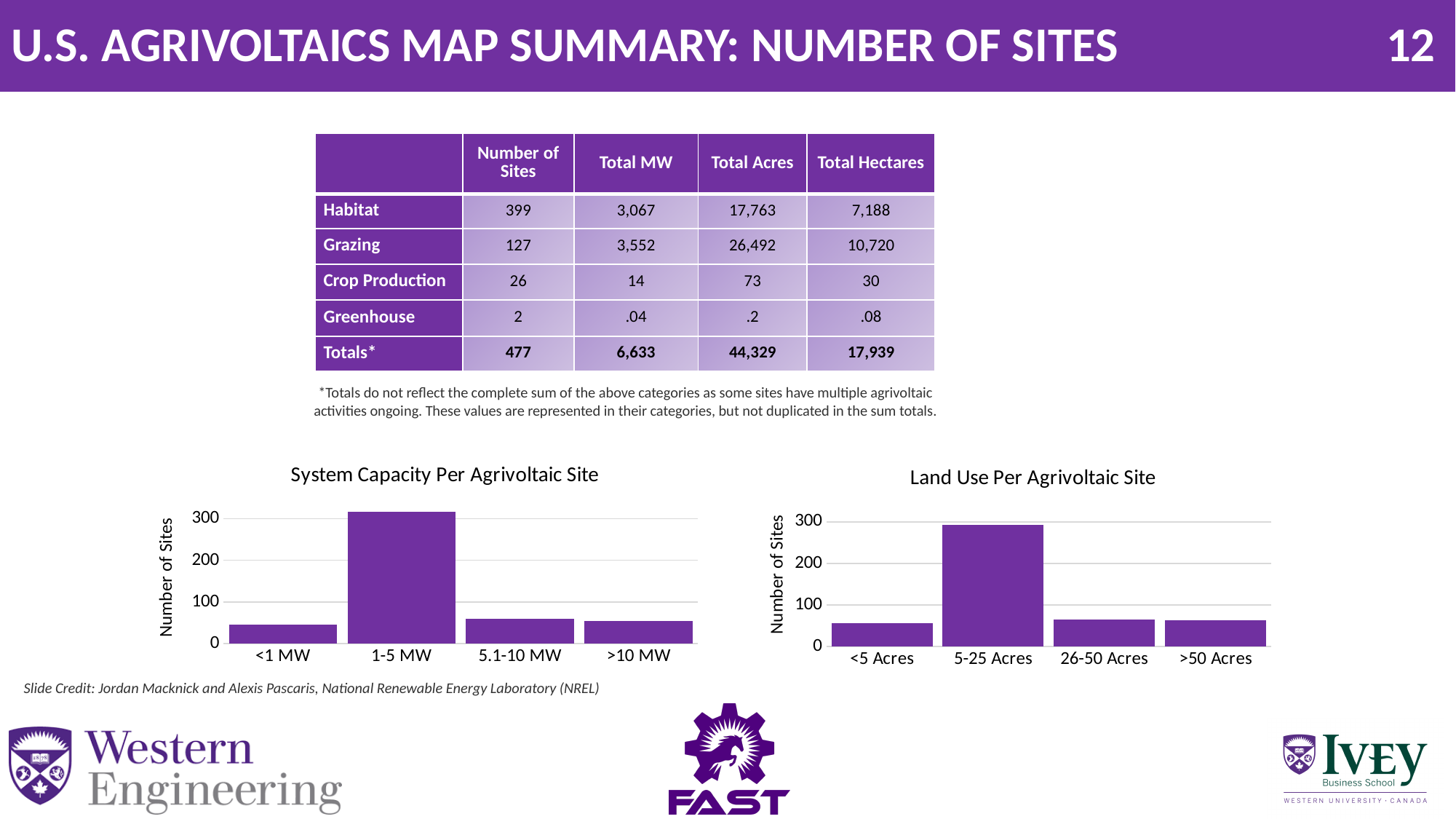
In the Land Use Per Agrivoltaic Site chart, is the number of sites for >50 Acres greater or less than 100? less In the System Capacity Per Agrivoltaic Site chart, is the number of sites for 1-5 MW greater or less than 200? greater In the System Capacity Per Agrivoltaic Site chart, which capacity range has the highest number of sites? 1-5 MW In the System Capacity Per Agrivoltaic Site chart, which has more sites: 1-5 MW or >10 MW? 1-5 MW What type of chart is the Land Use Per Agrivoltaic Site chart? Bar chart How many capacity categories are shown in the System Capacity Per Agrivoltaic Site chart? 4 In the Land Use Per Agrivoltaic Site chart, which has more sites: <5 Acres or 5-25 Acres? 5-25 Acres In the System Capacity Per Agrivoltaic Site chart, is the number of sites for <1 MW greater or less than 100? less In the Land Use Per Agrivoltaic Site chart, which acreage range has the highest number of sites? 5-25 Acres What is the y-axis label of the System Capacity Per Agrivoltaic Site chart? Number of Sites How many acreage categories are shown in the Land Use Per Agrivoltaic Site chart? 4